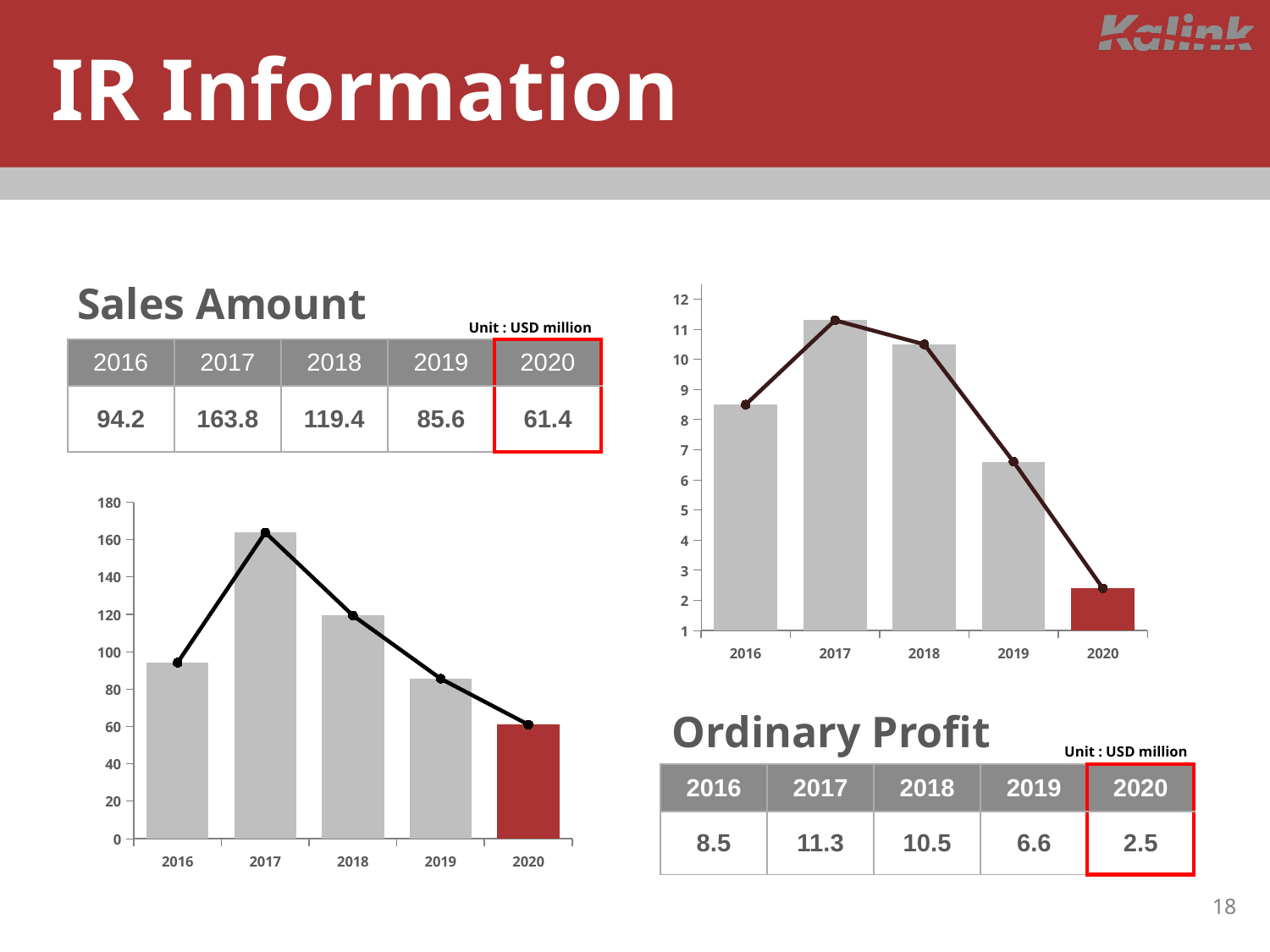
On the Ordinary Profit chart, what is the value for 2019? 6.6 On the Sales Amount chart, which year has the lowest value? 2020 On the Ordinary Profit chart, which year has the highest value? 2017 On the Sales Amount chart, what is the value for 2017? 163.8 On the Sales Amount chart, what is the difference between the 2017 and 2020 values? 102.4 On the Ordinary Profit chart, which is larger, the value for 2016 or the value for 2018? 2018 On the Sales Amount chart, how many years are plotted? 5 On the Ordinary Profit chart, do the values rise or fall from 2017 to 2020? fall On the Sales Amount chart, which year has the highest value? 2017 What unit is used for the values on the Sales Amount chart? USD million On the Ordinary Profit chart, what is the difference between the 2016 and 2020 values? 6 On the Sales Amount chart, is the value for 2018 greater or less than 100? greater